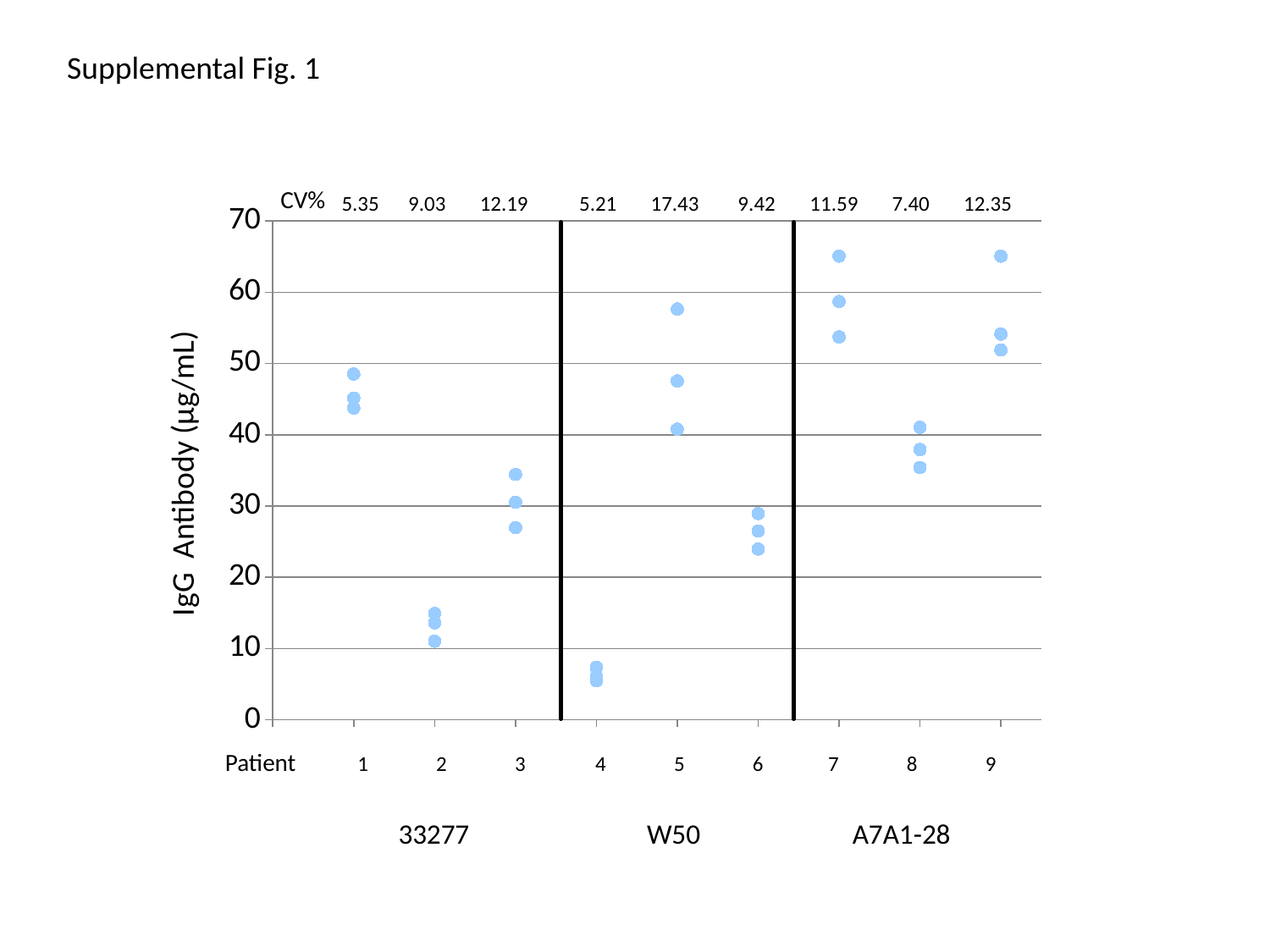
Which patient has higher IgG antibody values, patient 2 or patient 8? Patient 8 What is the difference between the CV% for patient 5 and the CV% for patient 4? 12.22 Are the IgG antibody values for patient 4 greater or less than 10 µg/mL? less What is the CV% printed for patient 9? 12.35 How many patients are plotted on the x axis? 9 Which patient has the lowest CV% value printed above the chart? Patient 4 Are the IgG antibody values for patient 7 greater or less than 50 µg/mL? greater What is the CV% printed for patient 1? 5.35 Which patient has the highest CV% value printed above the chart? Patient 5 What is the label of the y axis? IgG Antibody (µg/mL) What kind of chart is shown on the slide? Scatter (dot) plot What is the CV% printed for patient 5? 17.43